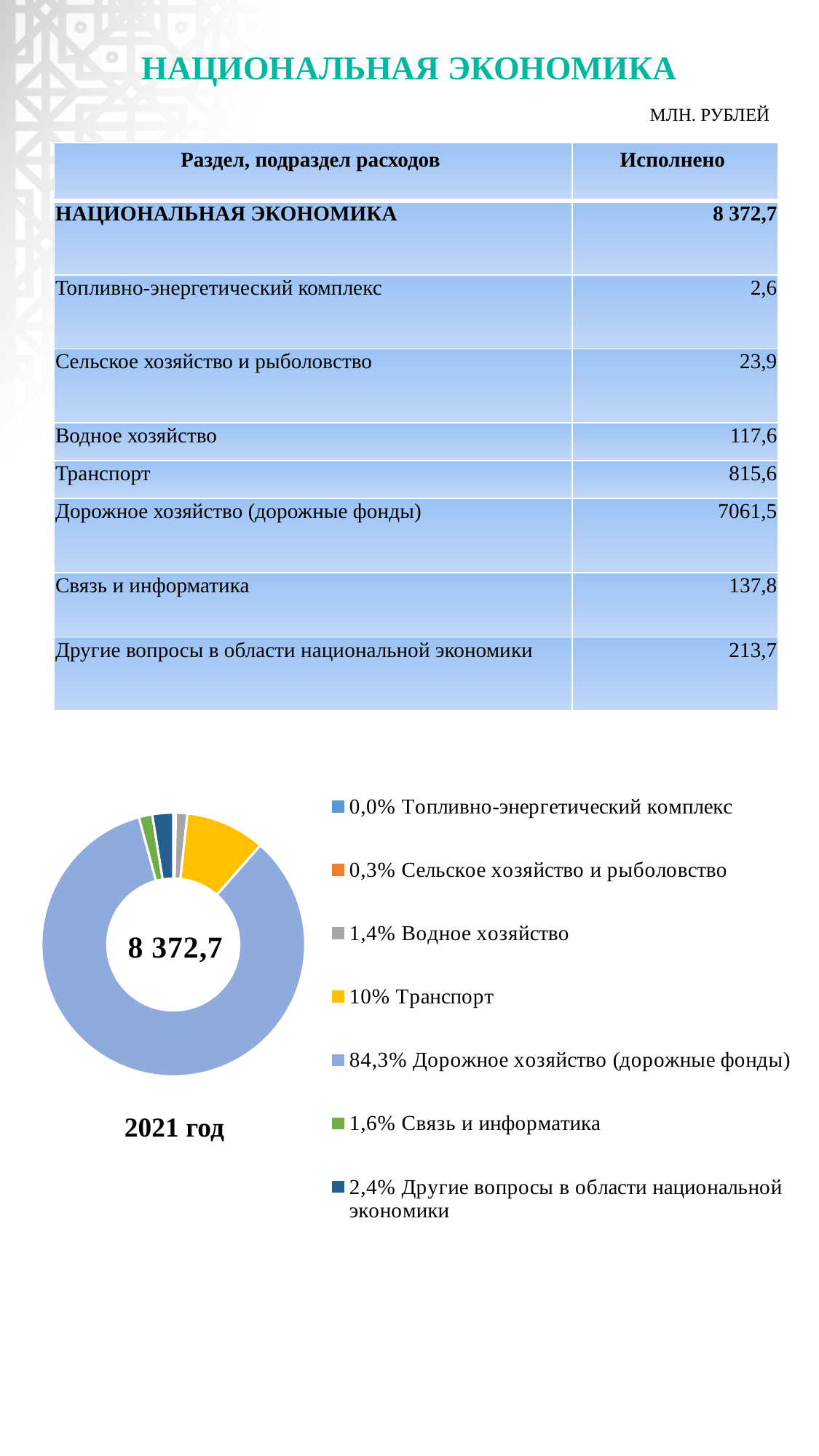
What share of the chart does Связь и информатика account for? 1,6% What share of the chart does Водное хозяйство account for? 1,4% Which category has the largest share of the chart? Дорожное хозяйство (дорожные фонды) What share of the chart does Дорожное хозяйство (дорожные фонды) account for? 84,3% What total value is printed in the centre of the doughnut chart? 8 372,7 How many categories does the chart's legend list? 7 What kind of chart is shown at the bottom of the slide? Doughnut (pie) chart Which has a larger share of the chart, Транспорт or Связь и информатика? Транспорт Which category has the smallest share of the chart? Топливно-энергетический комплекс What year is labelled beneath the doughnut chart? 2021 год